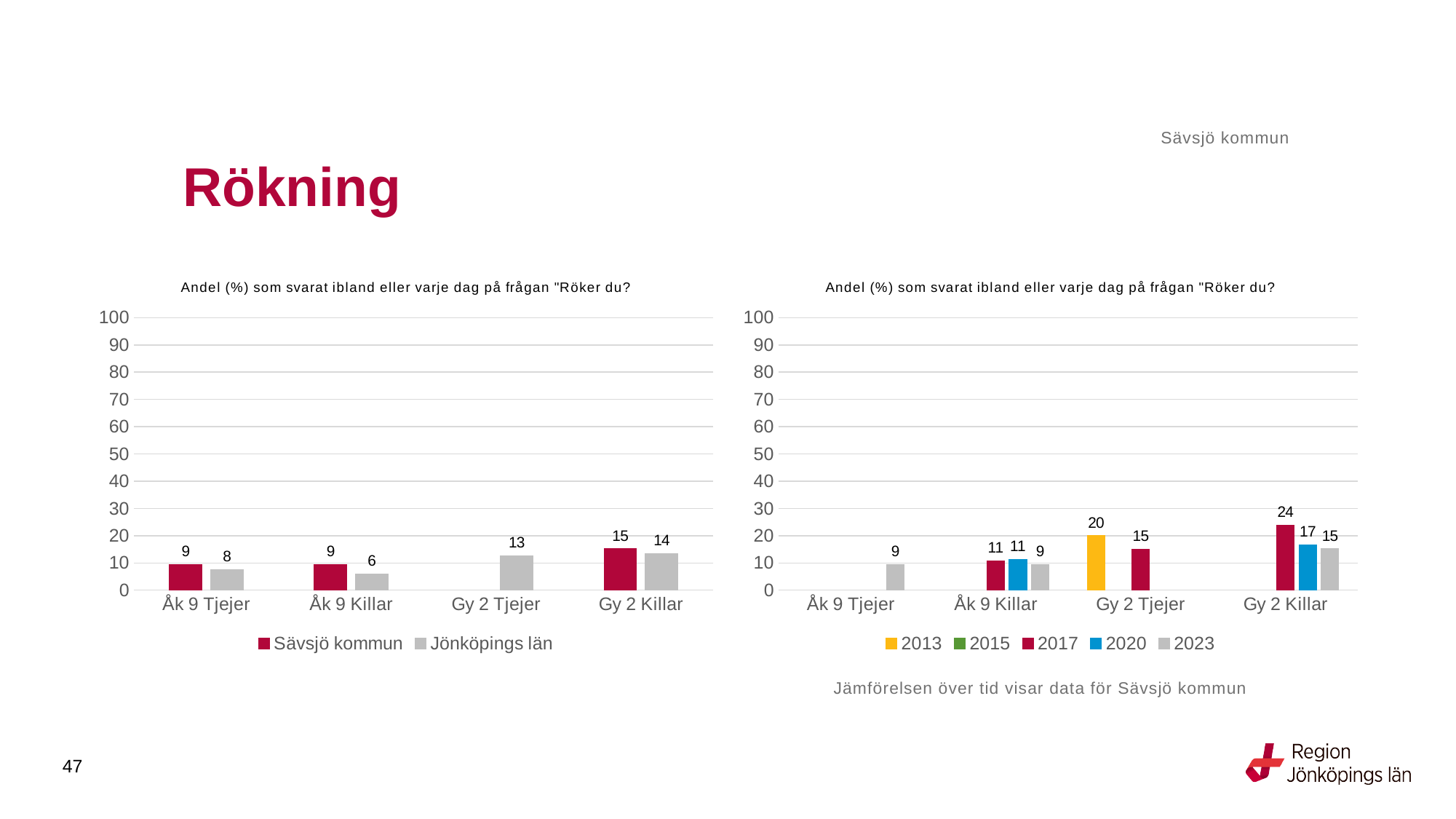
What type of chart is the right chart? Bar chart In the left chart, what is the difference between Sävsjö kommun and Jönköpings län for Åk 9 Killar? 3 In the left chart, what is the value for Sävsjö kommun for Gy 2 Killar? 15 In the left chart, how many series does the legend list? 2 In the right chart, which year has the highest value for Gy 2 Killar? 2017 In the left chart, which category has the highest value for Jönköpings län? Gy 2 Killar In the right chart, how many series does the legend list? 5 In the right chart, what is the value for 2020 for Gy 2 Killar? 17 In the right chart, what is the value for 2013 for Gy 2 Tjejer? 20 In the right chart, what is the difference between the 2017 and 2023 values for Gy 2 Killar? 9 In the left chart, what is the value for Jönköpings län for Åk 9 Killar? 6 In the left chart, how many categories are shown on the x axis? 4